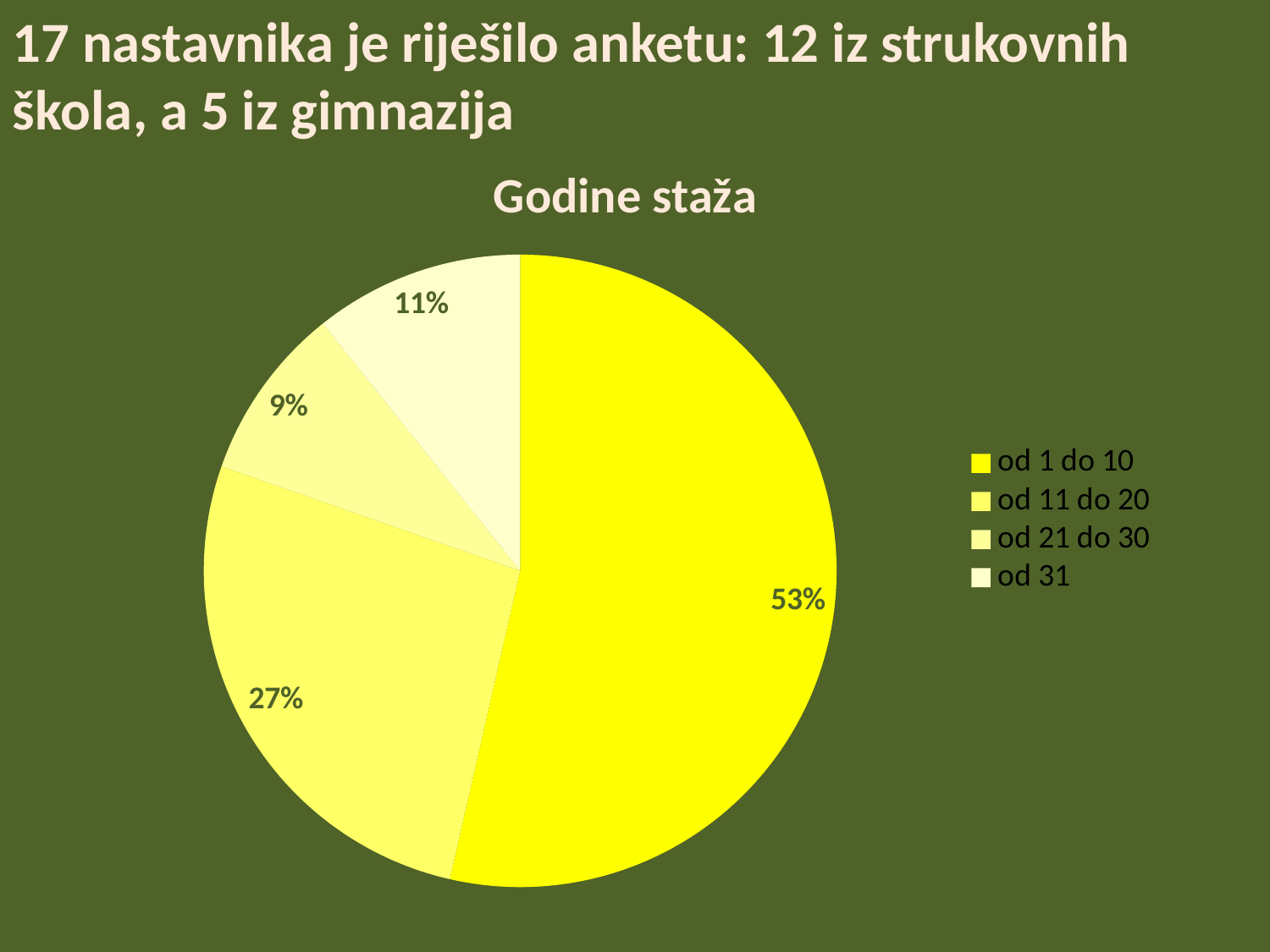
What is the title of the chart? Godine staža Which category has the smallest slice of the pie? od 21 do 30 What share of the pie does the 'od 1 do 10' slice take? 53% Which slice is larger, 'od 21 do 30' or 'od 31'? od 31 What share of the pie does the 'od 31' slice take? 11% What share of the pie does the 'od 21 do 30' slice take? 9% How many slices does the pie chart have? 4 What is the difference in percentage points between the 'od 1 do 10' slice and the 'od 11 do 20' slice? 26 What kind of chart is shown on the slide? pie chart Which category has the largest slice of the pie? od 1 do 10 How many entries does the legend list? 4